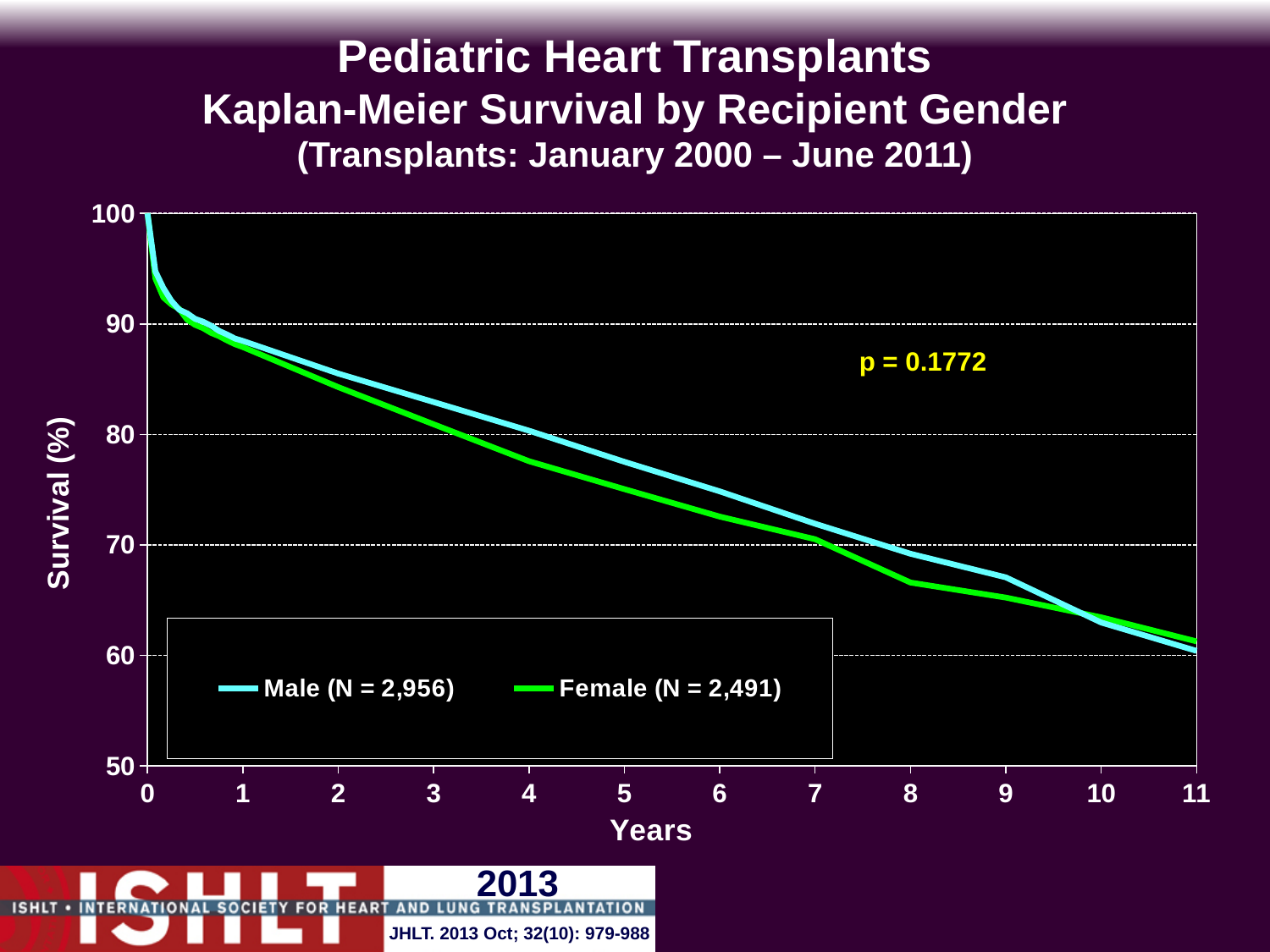
What kind of chart is shown on the slide? line chart What is the N for the Female group shown in the legend? 2,491 What is the N for the Male group shown in the legend? 2,956 How many series does the legend list? 2 Which colour represents the Female curve? green Is the Female survival at 8 years greater or less than 70? less Is the Male survival at 2 years greater or less than 80? greater Is the Male survival at 6 years greater or less than 70? greater Do the survival curves rise or fall as years increase? fall What p-value is printed on the chart? p = 0.1772 At 5 years, which group has higher survival, Male or Female? Male